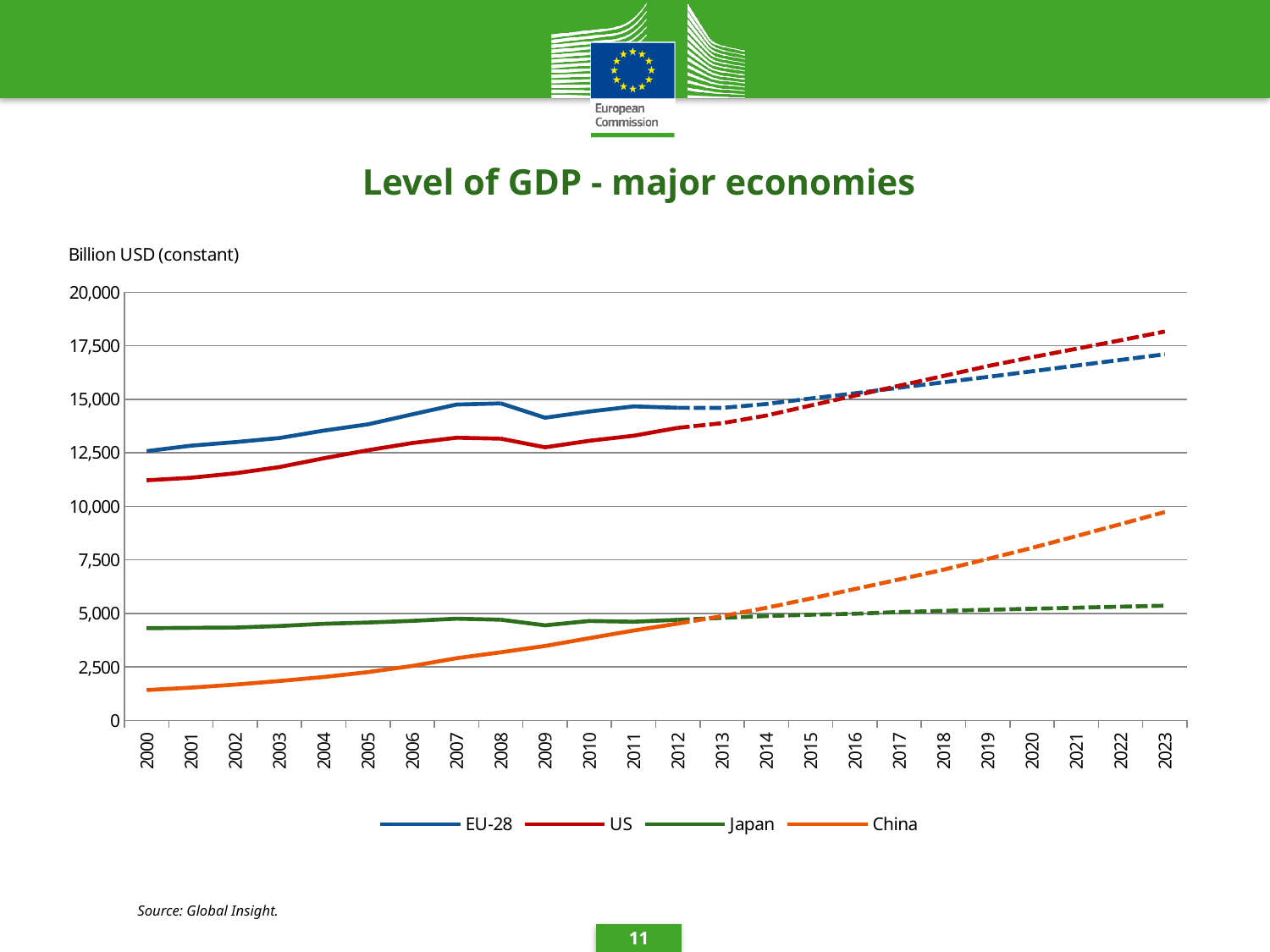
Which economy has the lowest GDP level in 2023? Japan Is the value for China in 2023 greater or less than 10,000? less In 2000, which is larger, the value for Japan or the value for China? Japan Which economy has the highest GDP level in 2000? EU-28 What kind of chart is shown on the slide? Line chart How many series does the legend list? 4 Which economy has the lowest GDP level in 2000? China Does the value for China rise or fall from 2000 to 2023? Rise Which economy has the highest GDP level in 2023? US Is the value for EU-28 in 2007 greater or less than 12,500? greater Is the value for Japan in 2000 greater or less than 5,000? less How many years are shown along the x axis? 24